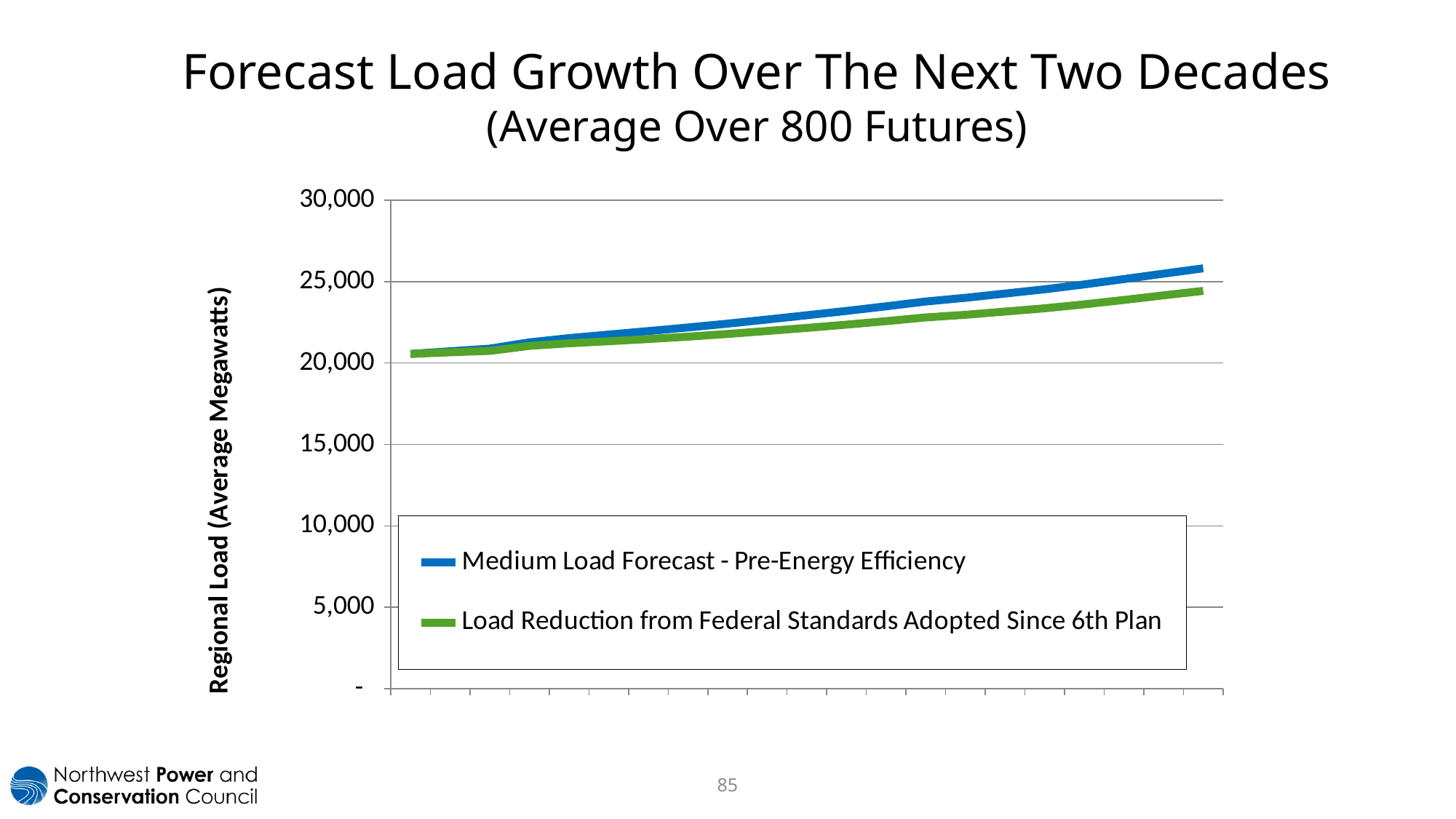
At the right end of the chart, which series is higher: Medium Load Forecast - Pre-Energy Efficiency or Load Reduction from Federal Standards Adopted Since 6th Plan? Medium Load Forecast - Pre-Energy Efficiency What is the title of the y axis? Regional Load (Average Megawatts) What kind of chart is shown on the slide? line chart Is the starting value of the Medium Load Forecast - Pre-Energy Efficiency line greater or less than 25,000? less Is the final value of the Medium Load Forecast - Pre-Energy Efficiency line greater or less than 25,000? greater Which colour is used for the Load Reduction from Federal Standards Adopted Since 6th Plan series? green Is the final value of the Load Reduction from Federal Standards Adopted Since 6th Plan line greater or less than 25,000? less Does the Medium Load Forecast - Pre-Energy Efficiency line rise or fall from left to right? rise Does the Load Reduction from Federal Standards Adopted Since 6th Plan line rise or fall along the x axis? rise How many series does the legend list? 2